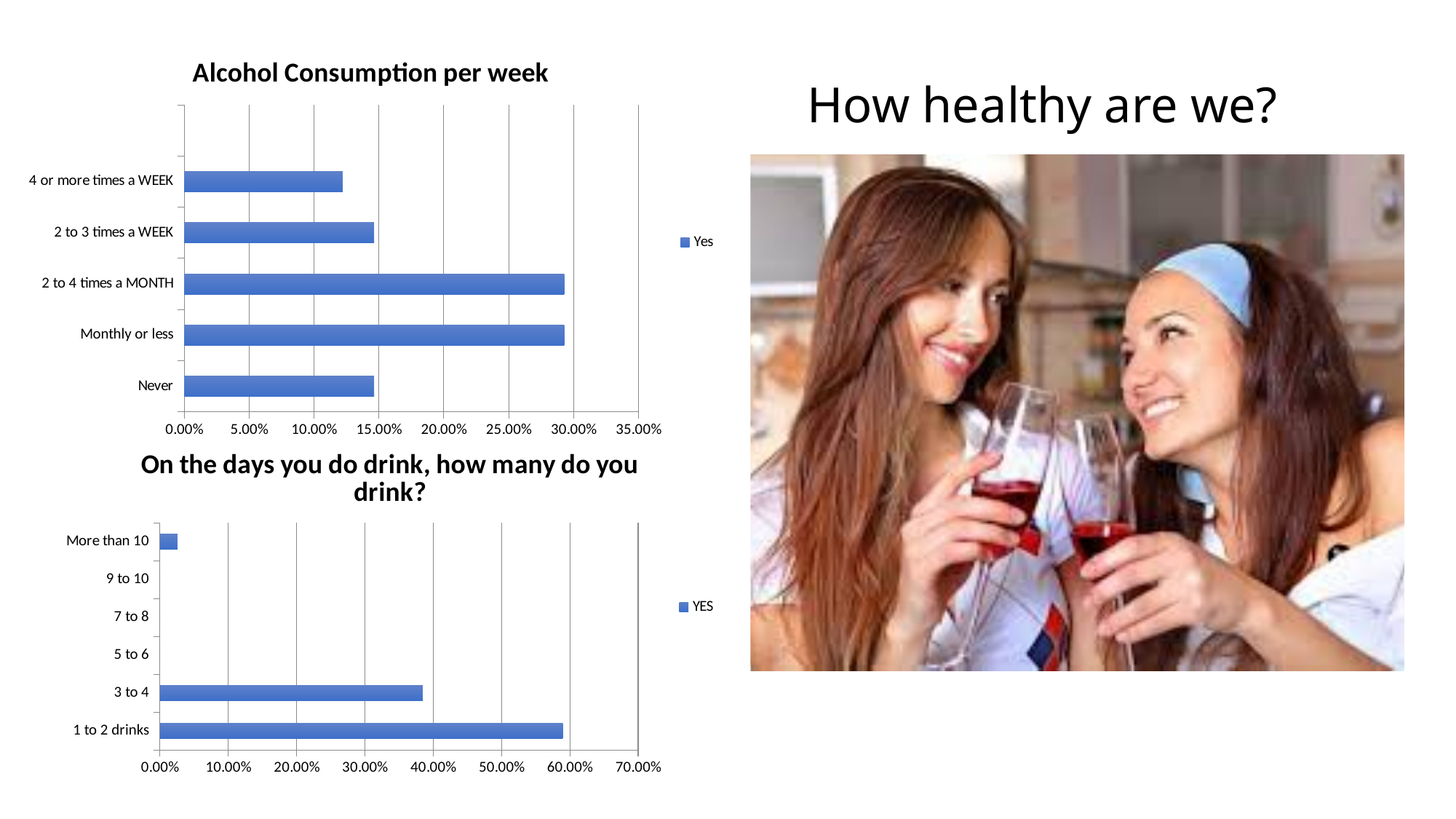
What type of chart is the "Alcohol Consumption per week" chart? bar chart In the "On the days you do drink, how many do you drink?" chart, is the value for "More than 10" greater or less than 10.00%? less In the "On the days you do drink, how many do you drink?" chart, is the value for "1 to 2 drinks" greater or less than 50.00%? greater What is the legend entry in the "On the days you do drink, how many do you drink?" chart? YES In the "Alcohol Consumption per week" chart, is the value for "2 to 4 times a MONTH" greater or less than 25.00%? greater In the "Alcohol Consumption per week" chart, which category has the lowest value? 4 or more times a WEEK How many categories are shown in the "On the days you do drink, how many do you drink?" chart? 6 How many series does the legend of the "Alcohol Consumption per week" chart list? 1 How many categories are shown in the "Alcohol Consumption per week" chart? 5 In the "On the days you do drink, how many do you drink?" chart, which category has the highest value? 1 to 2 drinks In the "Alcohol Consumption per week" chart, which is larger: "Monthly or less" or "2 to 3 times a WEEK"? Monthly or less